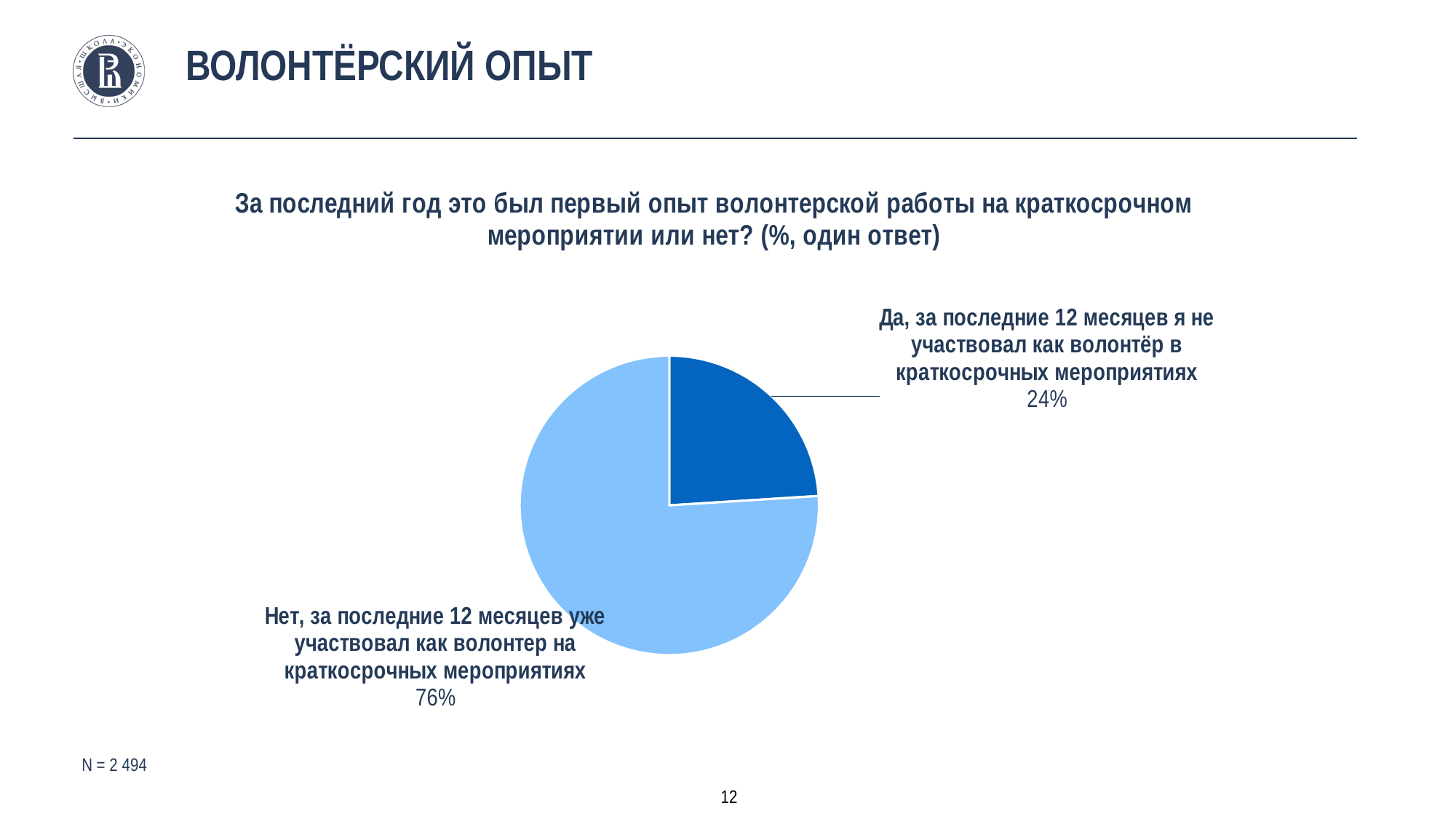
What is the sample size (N) shown on the slide? N = 2 494 What is the difference in percentage points between the "Нет" slice and the "Да" slice? 52 What kind of chart is shown on the slide? pie chart How many slices does the pie chart have? 2 What share of respondents answered "Да, за последние 12 месяцев я не участвовал как волонтёр в краткосрочных мероприятиях"? 24% Which answer option has the largest slice of the pie? Нет, за последние 12 месяцев уже участвовал как волонтер на краткосрочных мероприятиях Which is larger: the share for "Нет, за последние 12 месяцев уже участвовал..." or the share for "Да, за последние 12 месяцев я не участвовал..."? Нет, за последние 12 месяцев уже участвовал как волонтер на краткосрочных мероприятиях Which answer option has the smallest slice of the pie? Да, за последние 12 месяцев я не участвовал как волонтёр в краткосрочных мероприятиях What share of respondents answered "Нет, за последние 12 месяцев уже участвовал как волонтер на краткосрочных мероприятиях"? 76% What colour is the slice representing 24%? dark blue